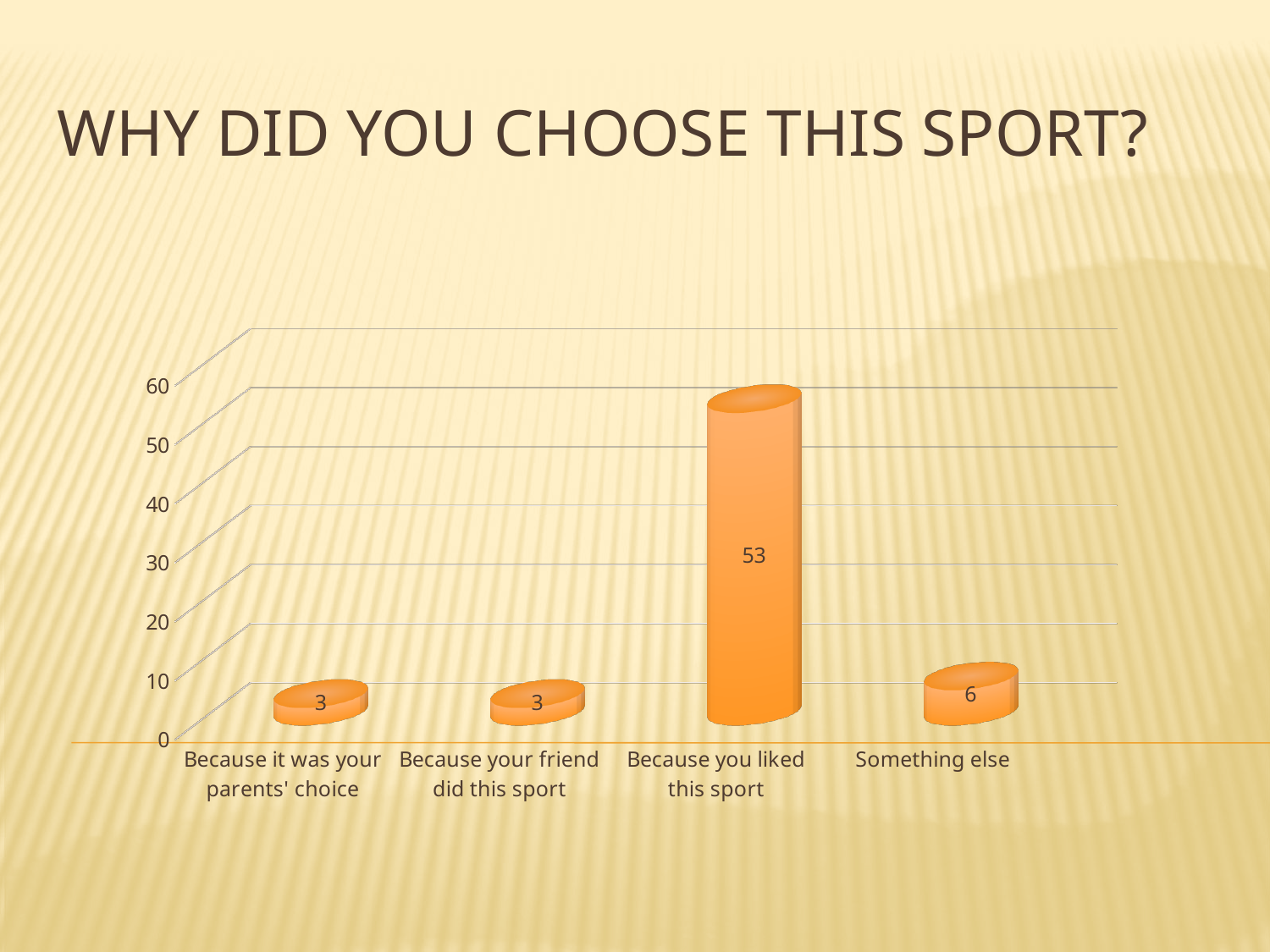
What kind of chart is shown on the slide? Bar chart What is the title of the slide containing the chart? WHY DID YOU CHOOSE THIS SPORT? What is the difference between the values for "Something else" and "Because it was your parents' choice"? 3 What is the difference between the values for "Because you liked this sport" and "Something else"? 47 What is the value for "Something else"? 6 How many categories are shown on the chart? 4 What is the value for "Because it was your parents' choice"? 3 Which is larger, the value for "Something else" or the value for "Because your friend did this sport"? Something else Which category has the highest value? Because you liked this sport What is the value for "Because your friend did this sport"? 3 What is the value for "Because you liked this sport"? 53 Is the value for "Because you liked this sport" greater or less than 50? greater